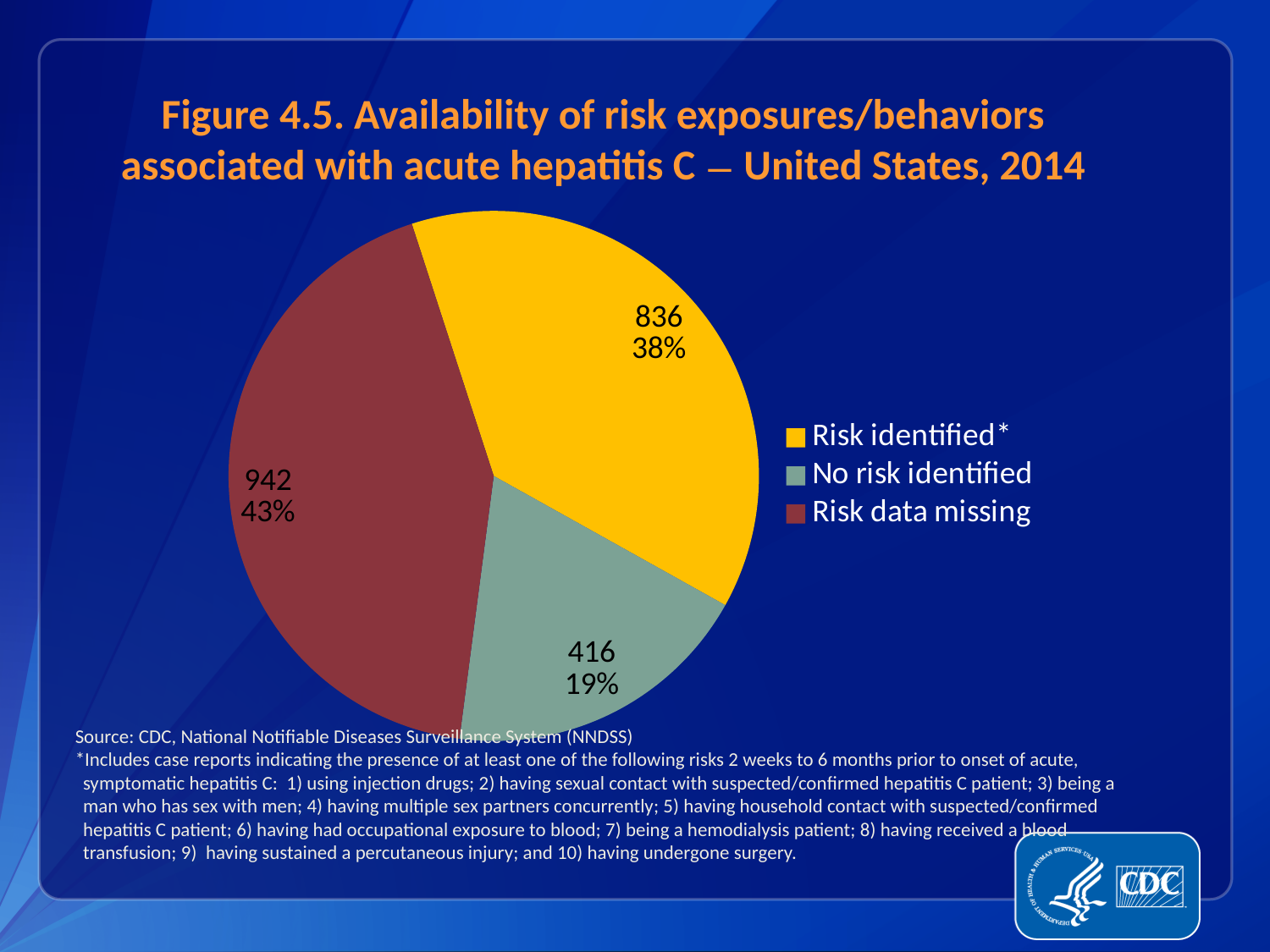
How many entries does the legend list? 3 What kind of chart is shown on the slide? pie chart Which category has the largest slice? Risk data missing What is the number of cases for 'Risk identified*'? 836 What is the number of cases for 'Risk data missing'? 942 How many slices does the pie chart have? 3 What is the difference in cases between 'Risk data missing' and 'Risk identified*'? 106 What is the number of cases for 'No risk identified'? 416 Which category has the smallest slice? No risk identified What share of the pie does 'No risk identified' represent? 19% What share of the pie does 'Risk data missing' represent? 43% Which colour represents 'Risk identified*' in the pie chart? yellow